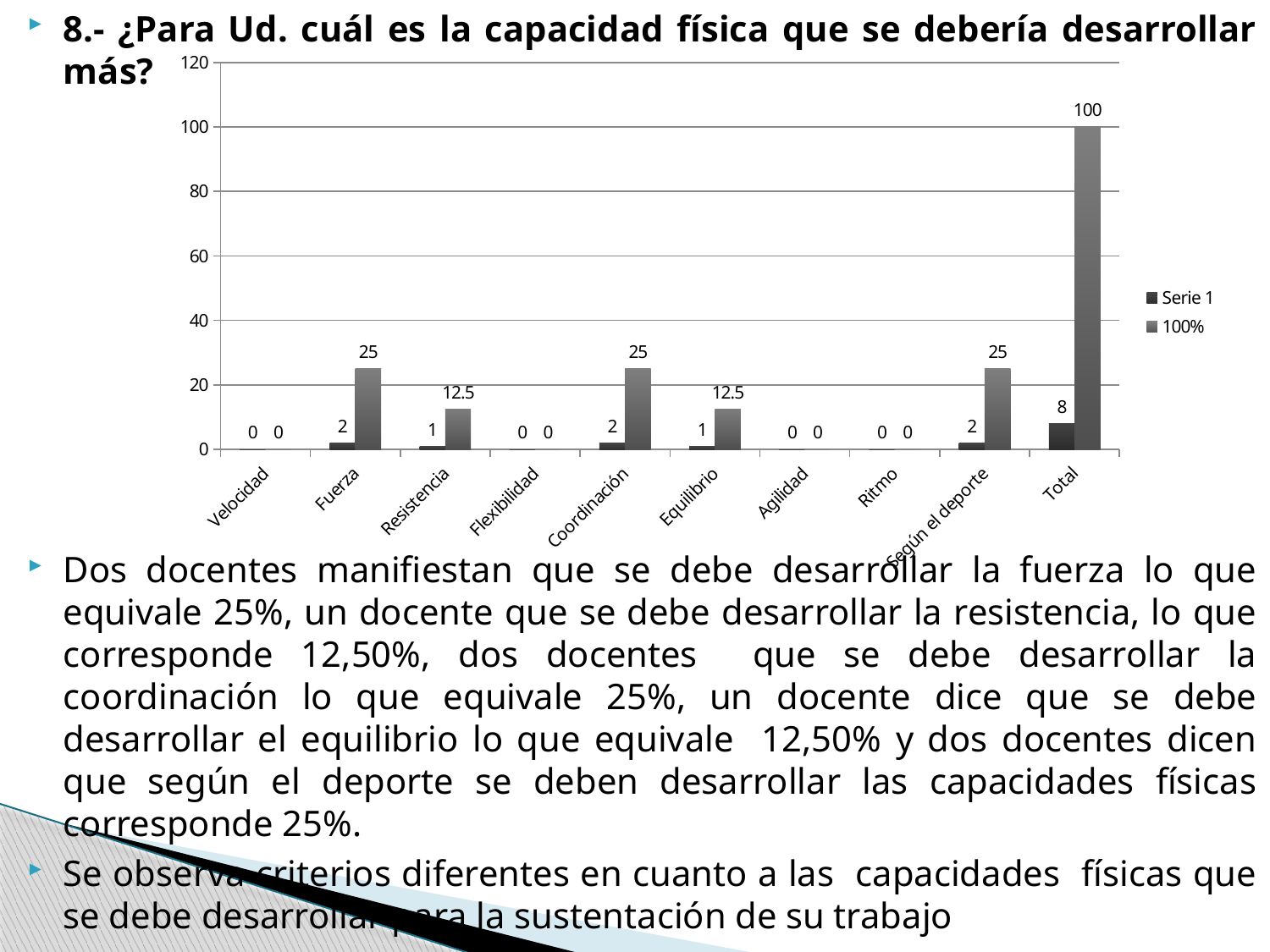
What is the value of Serie 1 for Resistencia? 1 What kind of chart is shown on the slide? bar chart What is the value of the 100% series for Equilibrio? 12.5 What are the two entries listed in the chart legend? Serie 1 and 100% Which is larger in the 100% series, Según el deporte or Equilibrio? Según el deporte What is the difference between the 100% series values for Coordinación and Resistencia? 12.5 Which category has the highest value in the 100% series? Total What is the value of Serie 1 for Total? 8 What is the value of the 100% series for Fuerza? 25 What is the value of Serie 1 for Flexibilidad? 0 How many categories are shown on the x axis of the chart? 10 How many series does the chart legend list? 2